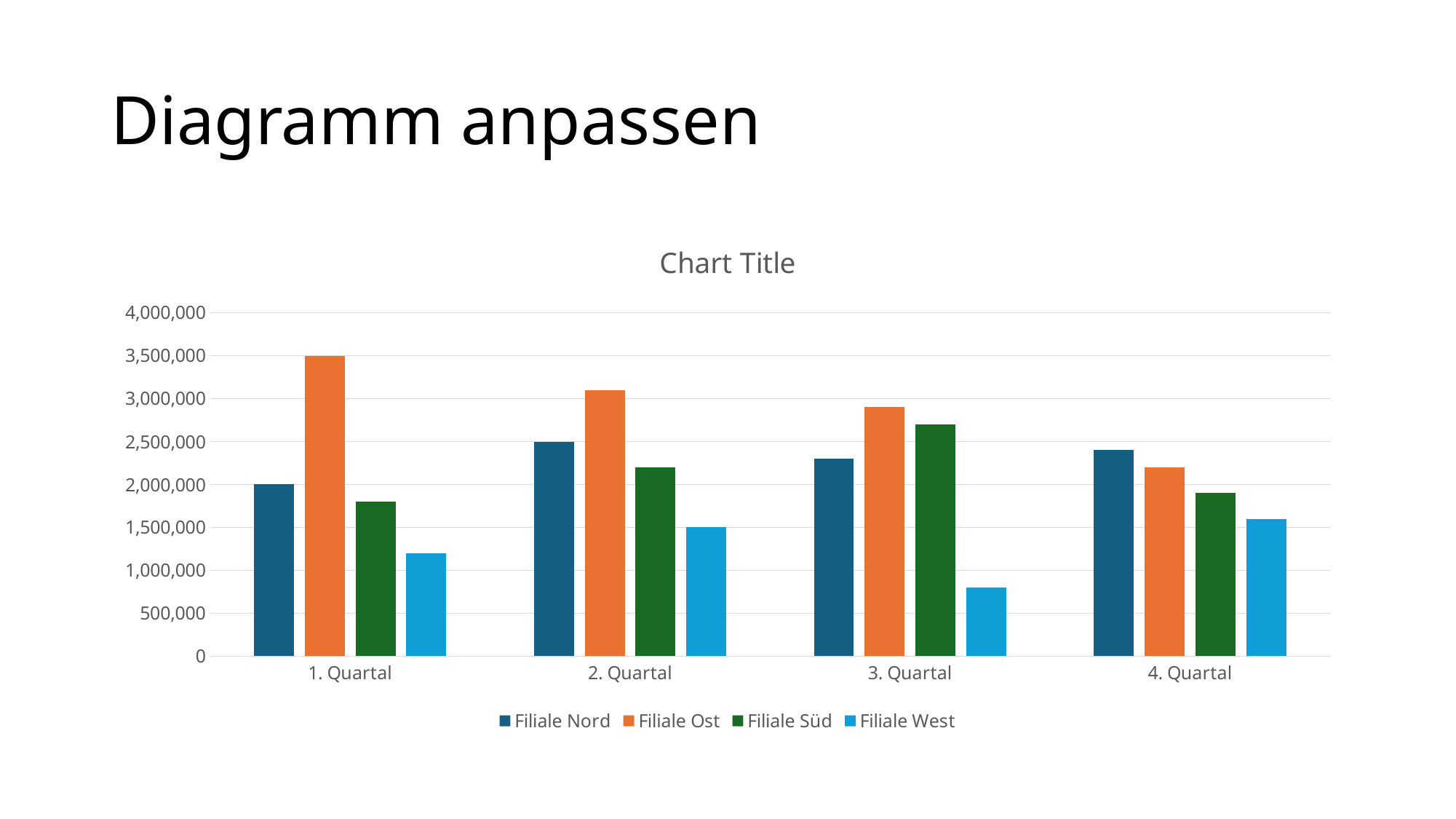
Which is larger in 4. Quartal, Filiale Nord or Filiale Ost? Filiale Nord Is the value for Filiale West in 3. Quartal greater or less than 1,000,000? less What is the value for Filiale Ost in 1. Quartal? 3,500,000 Do the values for Filiale Ost rise or fall from 1. Quartal to 4. Quartal? fall How many series does the legend list? 4 How many categories are shown on the x axis? 4 What kind of chart is shown on the slide? bar chart Is the value for Filiale Süd in 3. Quartal greater or less than 2,500,000? greater Which series has the lowest value in 3. Quartal? Filiale West What is the value for Filiale West in 2. Quartal? 1,500,000 Which series has the highest value in 1. Quartal? Filiale Ost What is the value for Filiale Nord in 1. Quartal? 2,000,000